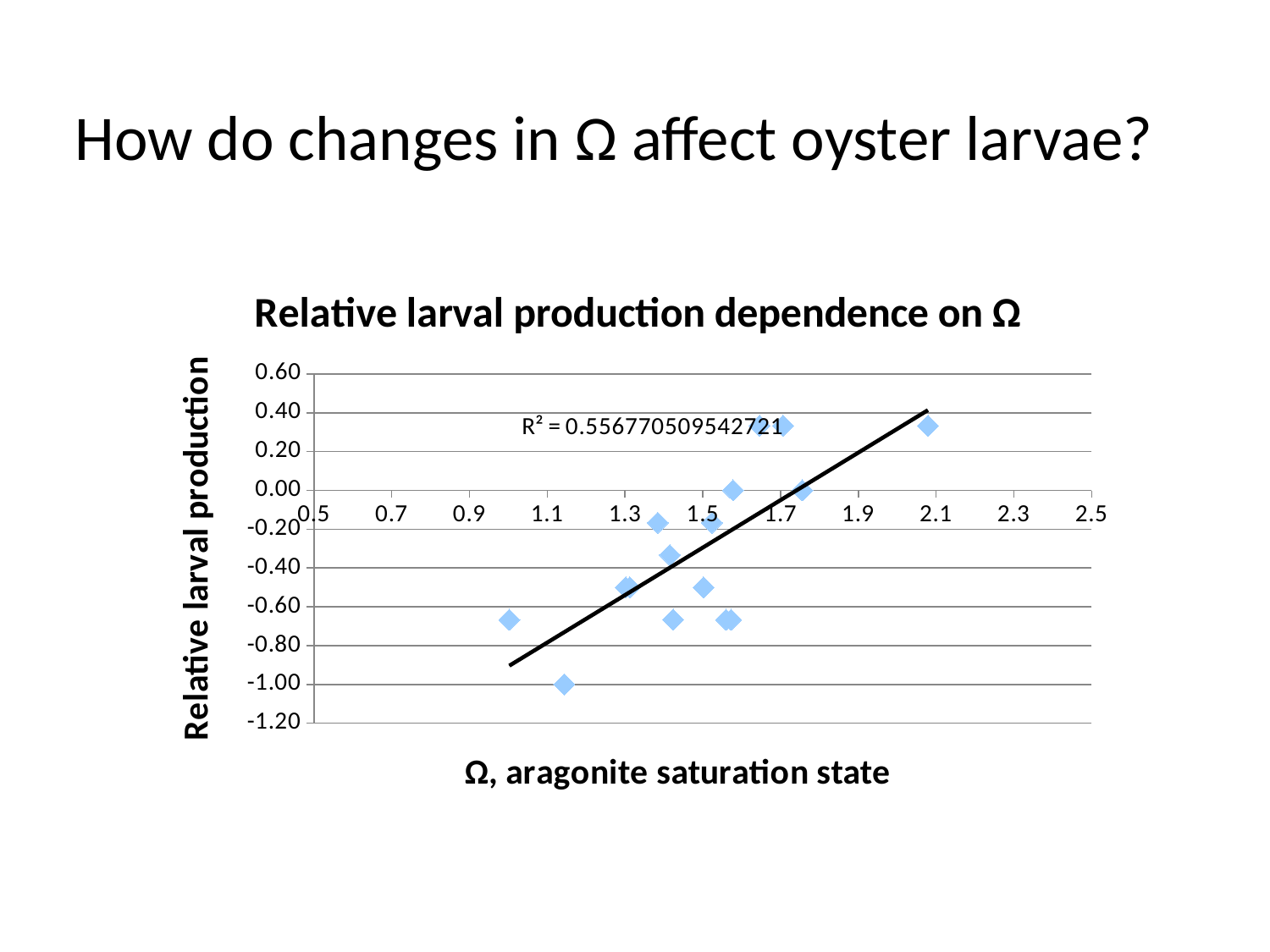
What is the title of the chart? Relative larval production dependence on Ω What is the maximum value shown on the y axis? 0.60 Does relative larval production rise or fall as Ω increases along the x axis? rise Is the relative larval production for the point at the highest Ω (about 2.1) greater or less than 0.20? greater Is the highest plotted relative larval production value greater or less than 0.40? less Which has the higher relative larval production: the point near Ω = 1.1 or the point near Ω = 2.1? the point near Ω = 2.1 What R² value is printed on the chart? R² = 0.556770509542721 What kind of chart is shown on the slide? scatter plot Is the relative larval production for the point at the lowest Ω (about 1.0) greater or less than -0.40? less What is the label of the x axis? Ω, aragonite saturation state